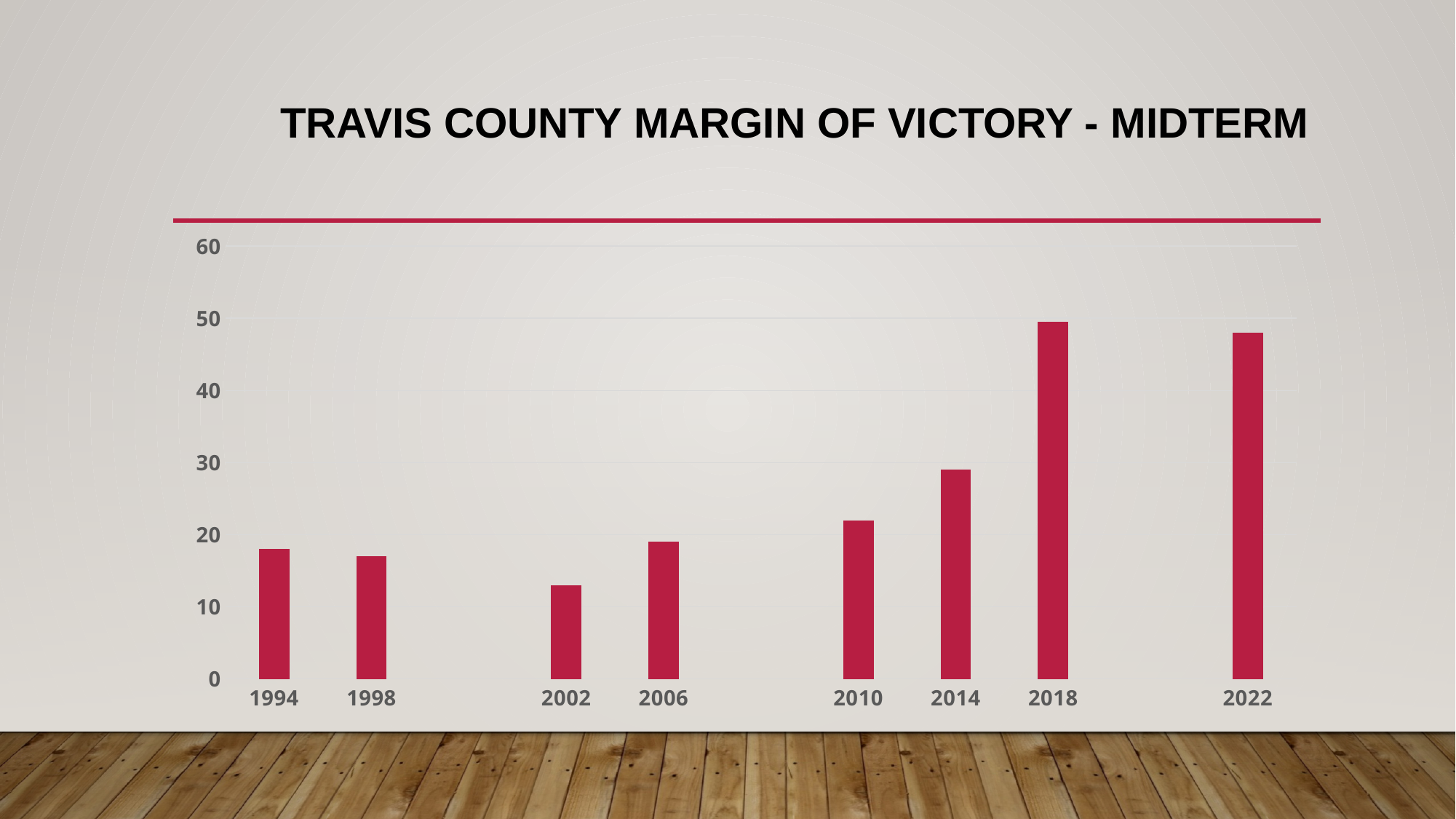
Which is larger, the value for 2006 or the value for 2002? 2006 Is the value for 1994 greater or less than 20? less Which year has the lowest margin of victory? 2002 Is the value for 2014 greater or less than 20? greater Do the values rise or fall from 2010 to 2018? rise Is the value for 2022 greater or less than 40? greater What kind of chart is shown on the slide? bar chart How many years (bars) are plotted in the chart? 8 Which is larger, the value for 2014 or the value for 2010? 2014 What is the title of the chart? Travis County Margin of Victory - Midterm